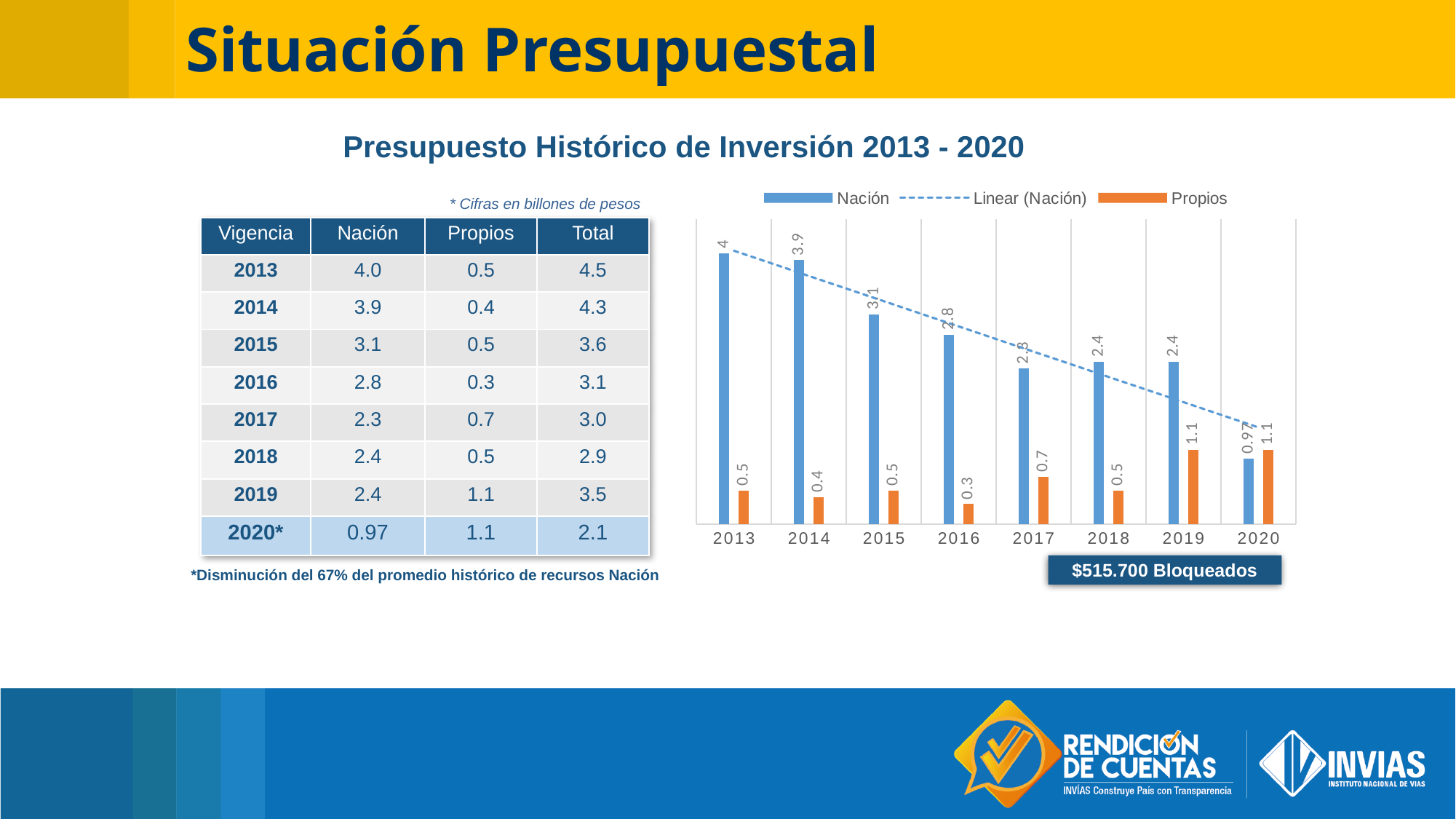
How many years are shown on the x axis of the chart? 8 What is the difference between the Nación values for 2013 and 2020? 3.03 What is the value of the Nación bar for 2020? 0.97 In which year is the Nación bar highest? 2013 What is the value of the Nación bar for 2016? 2.8 What is the difference between the Propios values for 2019 and 2018? 0.6 In which year is the Nación bar lowest? 2020 Which year has the larger Propios value, 2016 or 2019? 2019 Does the Nación series generally rise or fall from 2013 to 2020? fall What is the value of the Propios bar for 2017? 0.7 In which year is the Propios bar lowest? 2016 How many entries does the chart legend list? 3